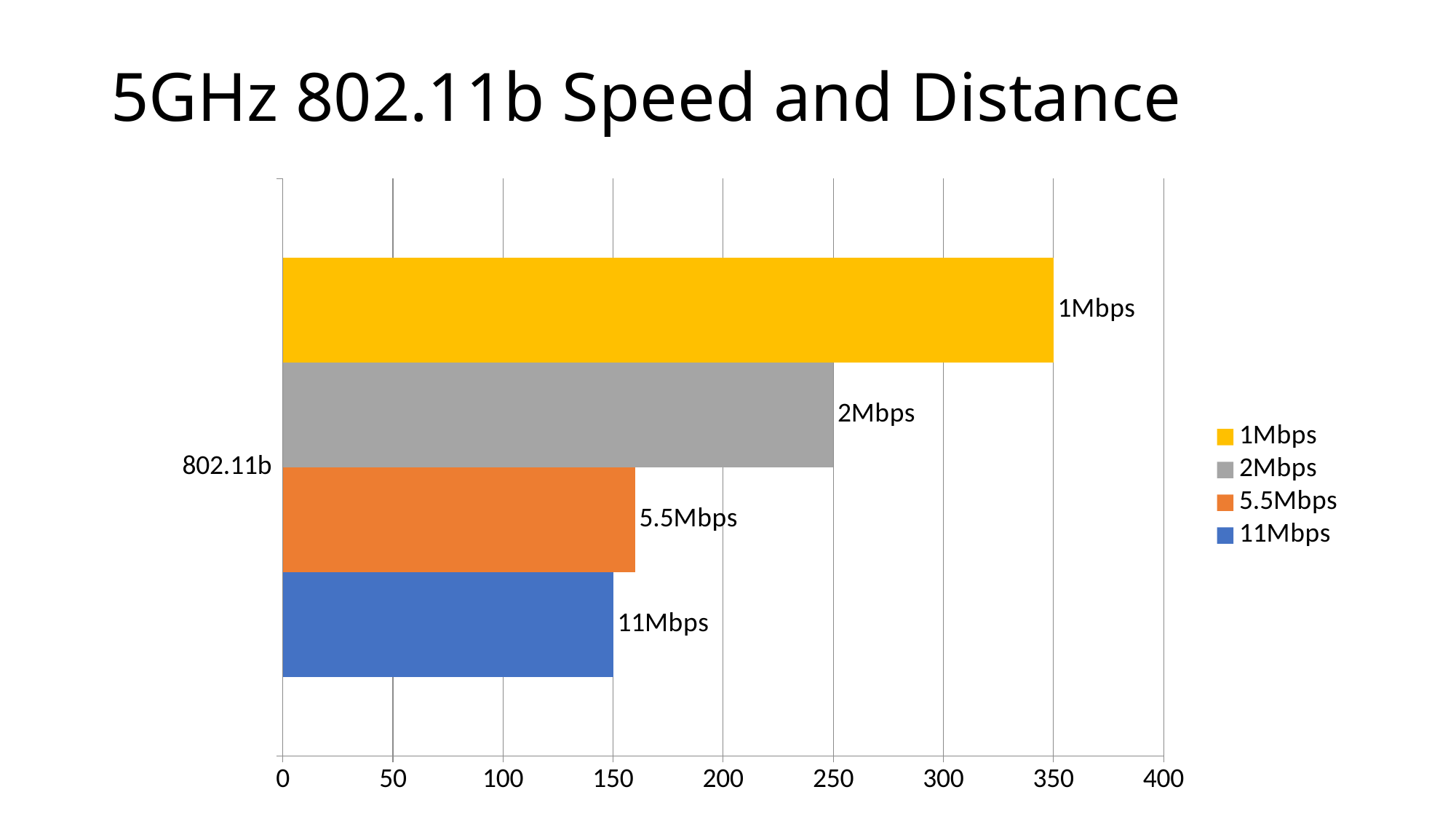
Is the value for 5.5Mbps greater or less than 200? less Which series has the longest bar? 1Mbps How many series does the legend list? 4 How many categories are shown on the vertical axis? 1 What is the value of the 11Mbps bar for 802.11b? 150 What is the title of the chart? 5GHz 802.11b Speed and Distance Which is larger, the 2Mbps value or the 5.5Mbps value? 2Mbps Which series has the shortest bar? 11Mbps What kind of chart is shown on the slide? bar chart What is the difference between the 1Mbps and 2Mbps values? 100 What is the value of the 1Mbps bar for 802.11b? 350 What is the value of the 2Mbps bar for 802.11b? 250